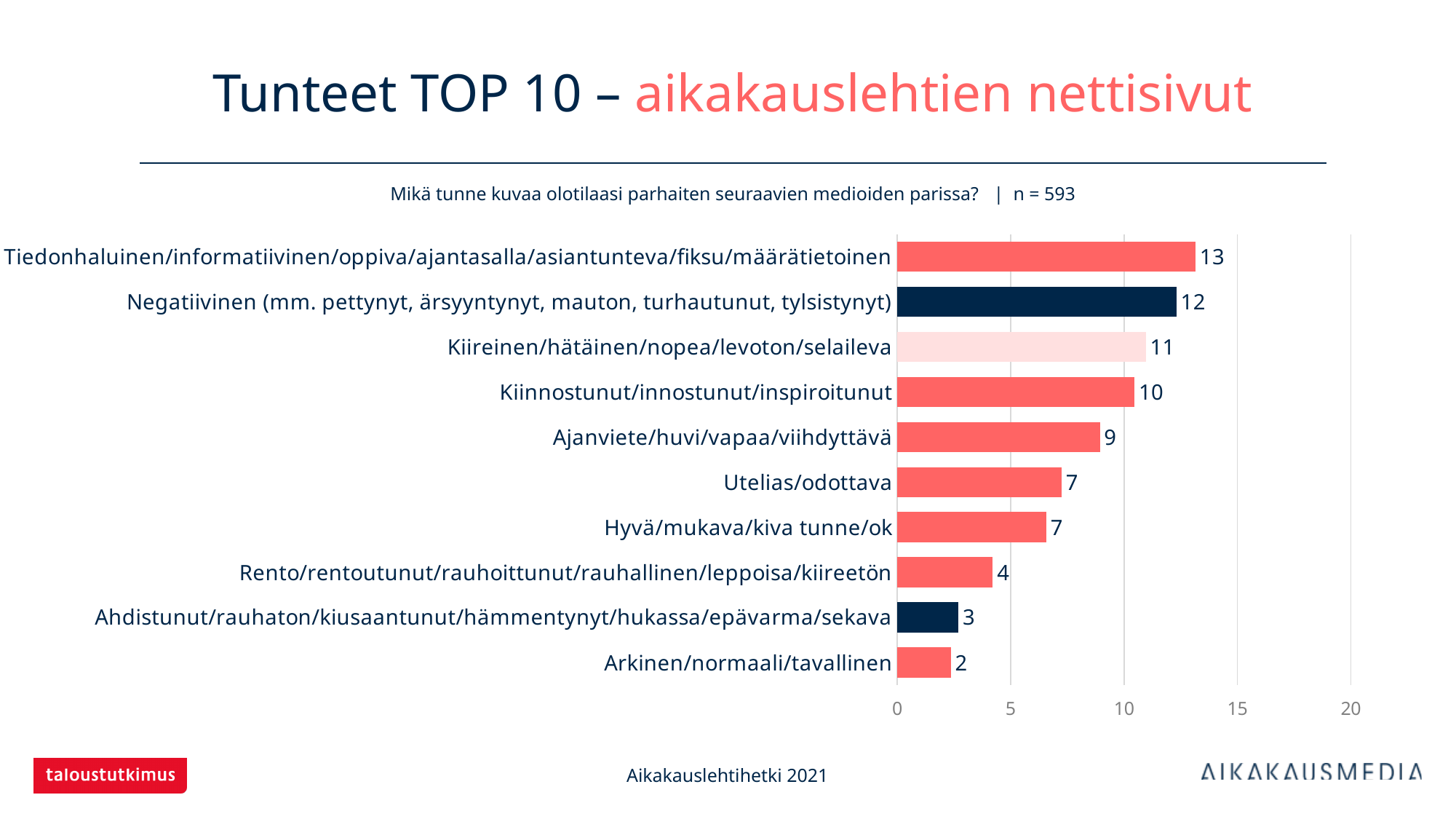
What is the value for Rento/rentoutunut/rauhoittunut/rauhallinen/leppoisa/kiireetön? 4 What is the difference between the values for Kiinnostunut/innostunut/inspiroitunut and Ahdistunut/rauhaton/kiusaantunut/hämmentynyt/hukassa/epävarma/sekava? 7 What is the value for Kiireinen/hätäinen/nopea/levoton/selaileva? 11 Is the value for Tiedonhaluinen/informatiivinen/oppiva/ajantasalla/asiantunteva/fiksu/määrätietoinen greater or less than 10? greater What is the value for Negatiivinen (mm. pettynyt, ärsyyntynyt, mauton, turhautunut, tylsistynyt)? 12 Which category has the highest value? Tiedonhaluinen/informatiivinen/oppiva/ajantasalla/asiantunteva/fiksu/määrätietoinen What is the sample size (n) stated on the slide? 593 What kind of chart is shown on the slide? bar chart What is the highest value shown on the x axis? 20 Which category has the lowest value? Arkinen/normaali/tavallinen How many categories are shown in the chart? 10 Which is larger, the value for Ajanviete/huvi/vapaa/viihdyttävä or the value for Utelias/odottava? Ajanviete/huvi/vapaa/viihdyttävä